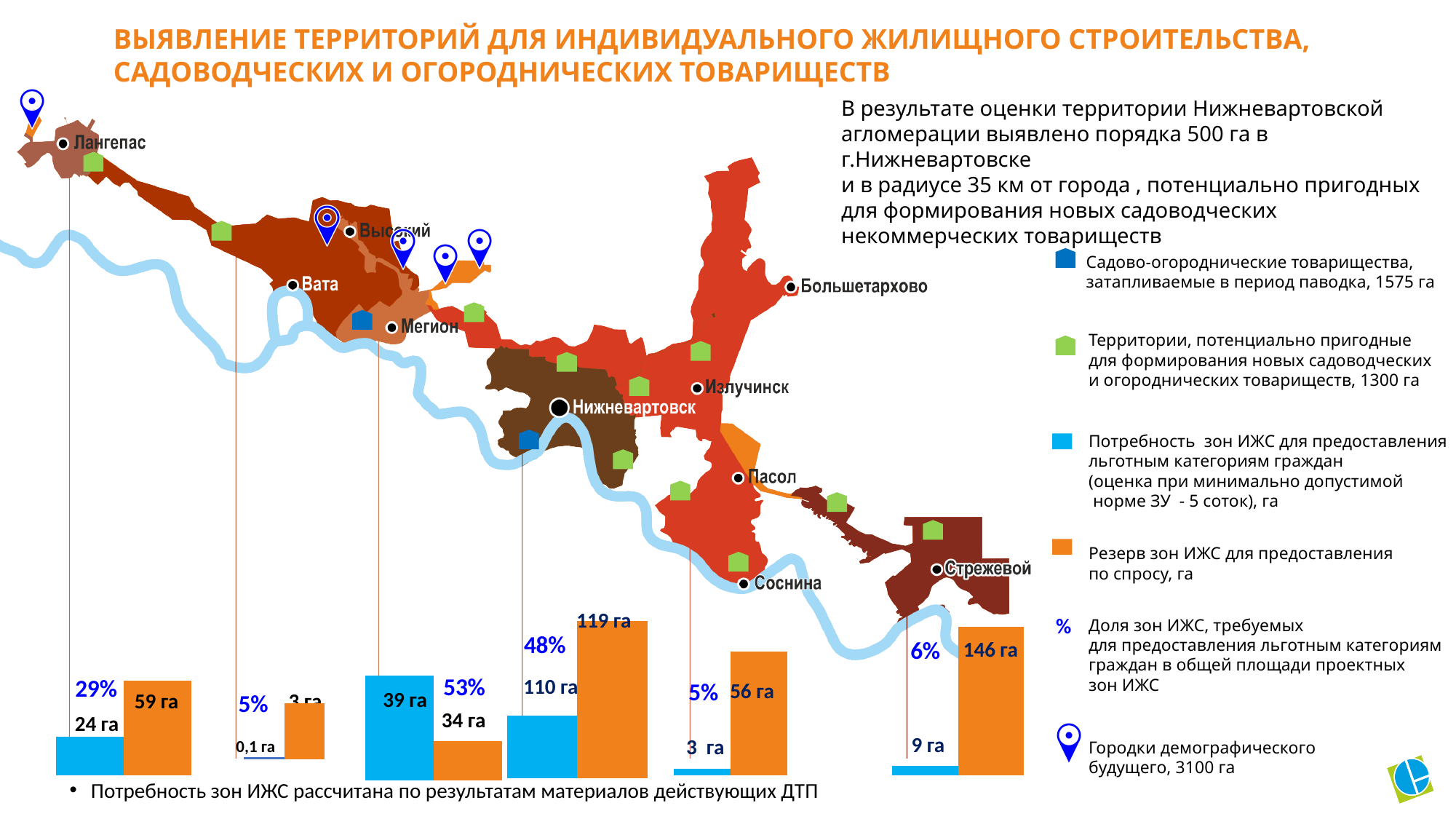
In the bar chart at the bottom of the slide, what percentage is shown for the rightmost group of bars? 6% In the bar chart at the bottom of the slide, what is the difference between the orange bar (146 га) and the blue bar (9 га) in the rightmost group? 137 га How many groups of bars are shown in the bar chart at the bottom of the slide? 6 In the bar chart at the bottom of the slide, what is the highest percentage label shown above the bar groups? 53% In the bar chart at the bottom of the slide, in the group labelled 53%, which bar is larger: the blue bar or the orange bar? the blue bar (39 га) What type of chart is shown at the bottom of the slide? bar chart In the bar chart at the bottom of the slide, what is the difference between the orange bar (119 га) and the blue bar (110 га) in the group labelled 48%? 9 га In the bar chart at the bottom of the slide, what is the value of the blue bar in the leftmost group (labelled 29%)? 24 га According to the legend, which colour represents 'Резерв зон ИЖС для предоставления по спросу, га'? orange In the bar chart at the bottom of the slide, what is the largest orange bar value shown? 146 га In the bar chart at the bottom of the slide, what is the value of the orange bar in the leftmost group (labelled 29%)? 59 га In the bar chart at the bottom of the slide, what is the smallest blue bar value shown? 0,1 га